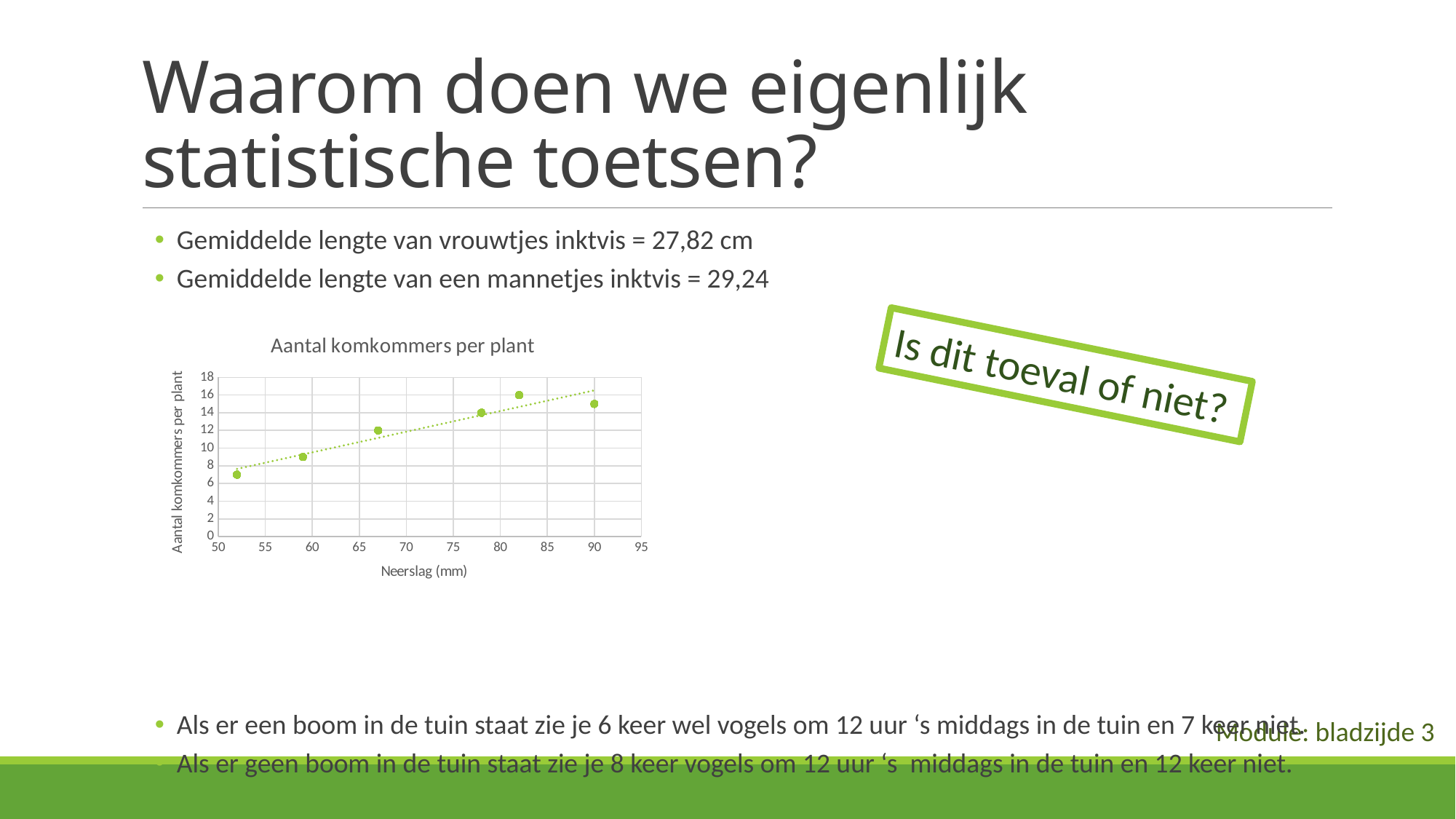
Is the value for the leftmost data point (around 52 mm Neerslag) greater or less than 10? less What is the highest value shown on the y axis of the chart? 18 Which data point has the lowest number of komkommers per plant: the one at around 52 mm or the one at around 90 mm Neerslag? the one at around 52 mm Is the value for the data point at around 59 mm Neerslag greater or less than 12? less Is the value for the rightmost data point (around 90 mm Neerslag) greater or less than 12? greater What kind of chart is shown on the slide? scatter plot Which data point has the lowest value in the chart? the leftmost point, at around 52 mm Neerslag What is the title of the chart? Aantal komkommers per plant What is the label of the x axis of the chart? Neerslag (mm) How many data points are plotted in the chart? 6 Do the values in the chart generally rise or fall as Neerslag (mm) increases? rise